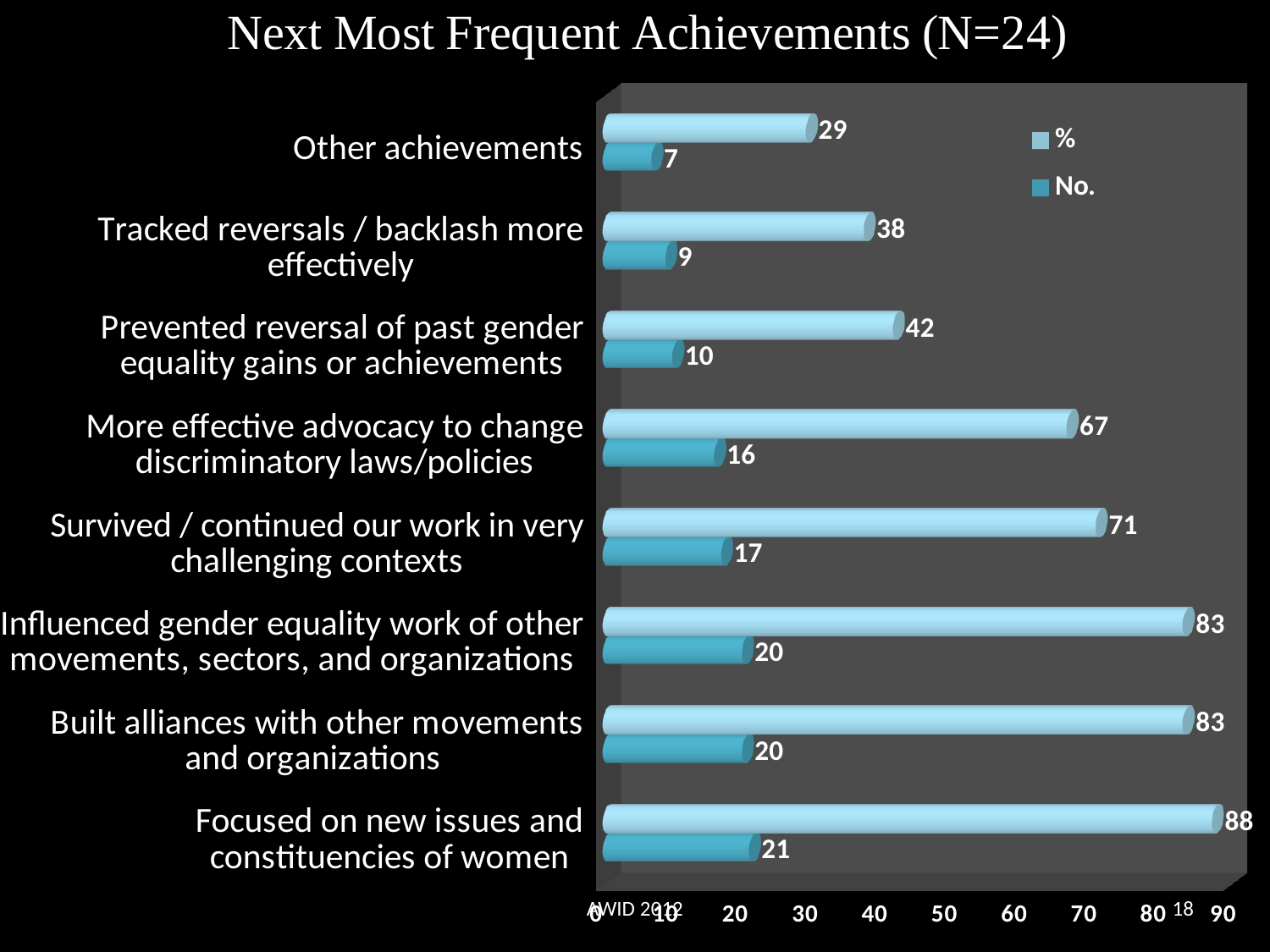
What is the % value for 'Tracked reversals / backlash more effectively'? 38 What is the difference between the % values for 'More effective advocacy to change discriminatory laws/policies' and 'Prevented reversal of past gender equality gains or achievements'? 25 What is the No. value for 'Built alliances with other movements and organizations'? 20 What is the title of the chart? Next Most Frequent Achievements (N=24) How many categories are shown on the chart? 8 Which category has the highest % value? Focused on new issues and constituencies of women What is the No. value for 'Survived / continued our work in very challenging contexts'? 17 Which category has the lowest No. value? Other achievements Which has a larger No. value: 'Other achievements' or 'Tracked reversals / backlash more effectively'? Tracked reversals / backlash more effectively How many series does the legend list? 2 What is the % value for 'Focused on new issues and constituencies of women'? 88 What kind of chart is shown on the slide? Bar chart